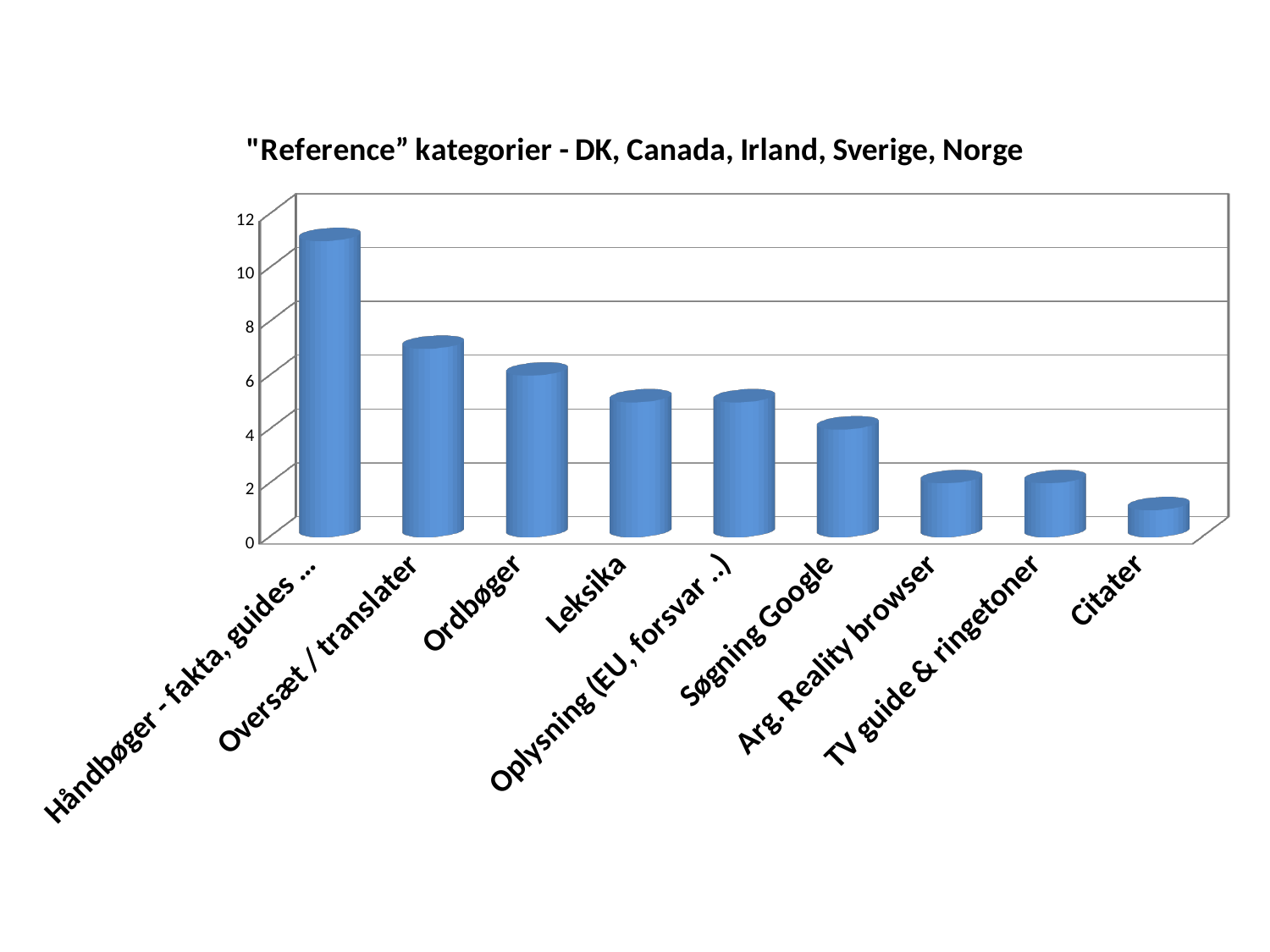
Is the value for Søgning Google greater or less than 6? less What kind of chart is shown on the slide? Bar chart Is the value for Oversæt / translater greater or less than 6? greater What is the title of the chart? "Reference" kategorier - DK, Canada, Irland, Sverige, Norge Which is larger, the value for Søgning Google or the value for Citater? Søgning Google Do the values generally rise or fall from left to right along the x axis? Fall Which category has the lowest value? Citater Which category has the highest value? Håndbøger - fakta, guides ... Which is larger, the value for Oversæt / translater or the value for Ordbøger? Oversæt / translater How many categories are plotted on the x axis? 9 Is the value for Håndbøger - fakta, guides ... greater or less than 8? greater